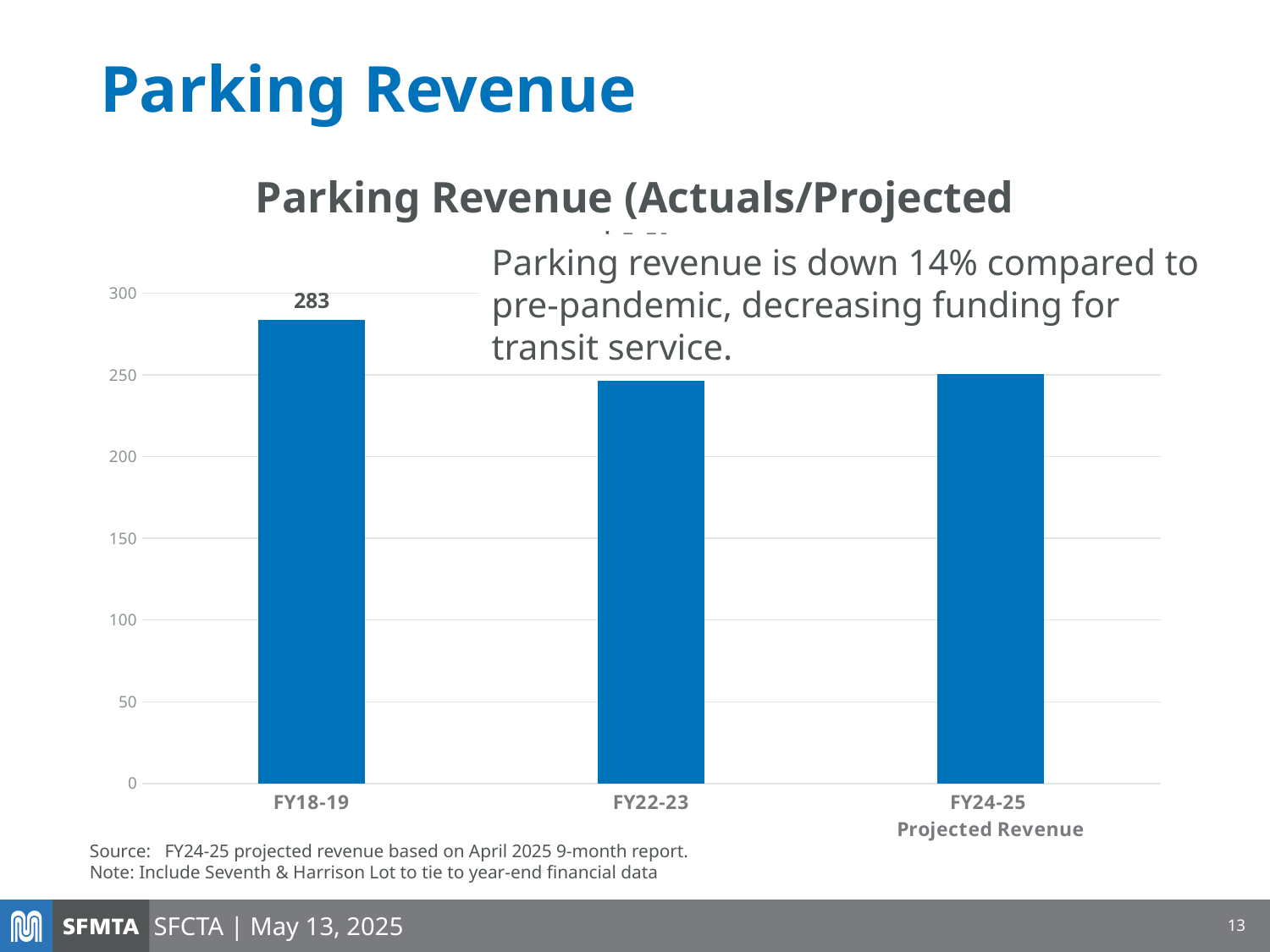
What colour are the bars in the chart? blue Is the value for FY22-23 greater or less than 200? greater How many fiscal years (bars) are shown in the chart? 3 What is the title of the slide? Parking Revenue What is the parking revenue value shown for FY18-19? 283 What kind of chart is shown on the slide? bar chart Which fiscal year has the highest parking revenue in the chart? FY18-19 Is the parking revenue for FY22-23 higher or lower than for FY18-19? lower Is the value for FY18-19 greater or less than 300? less Does parking revenue rise or fall from FY18-19 to FY22-23? fall Is the parking revenue for FY24-25 Projected Revenue higher or lower than for FY18-19? lower Is the value for FY24-25 Projected Revenue greater or less than 200? greater